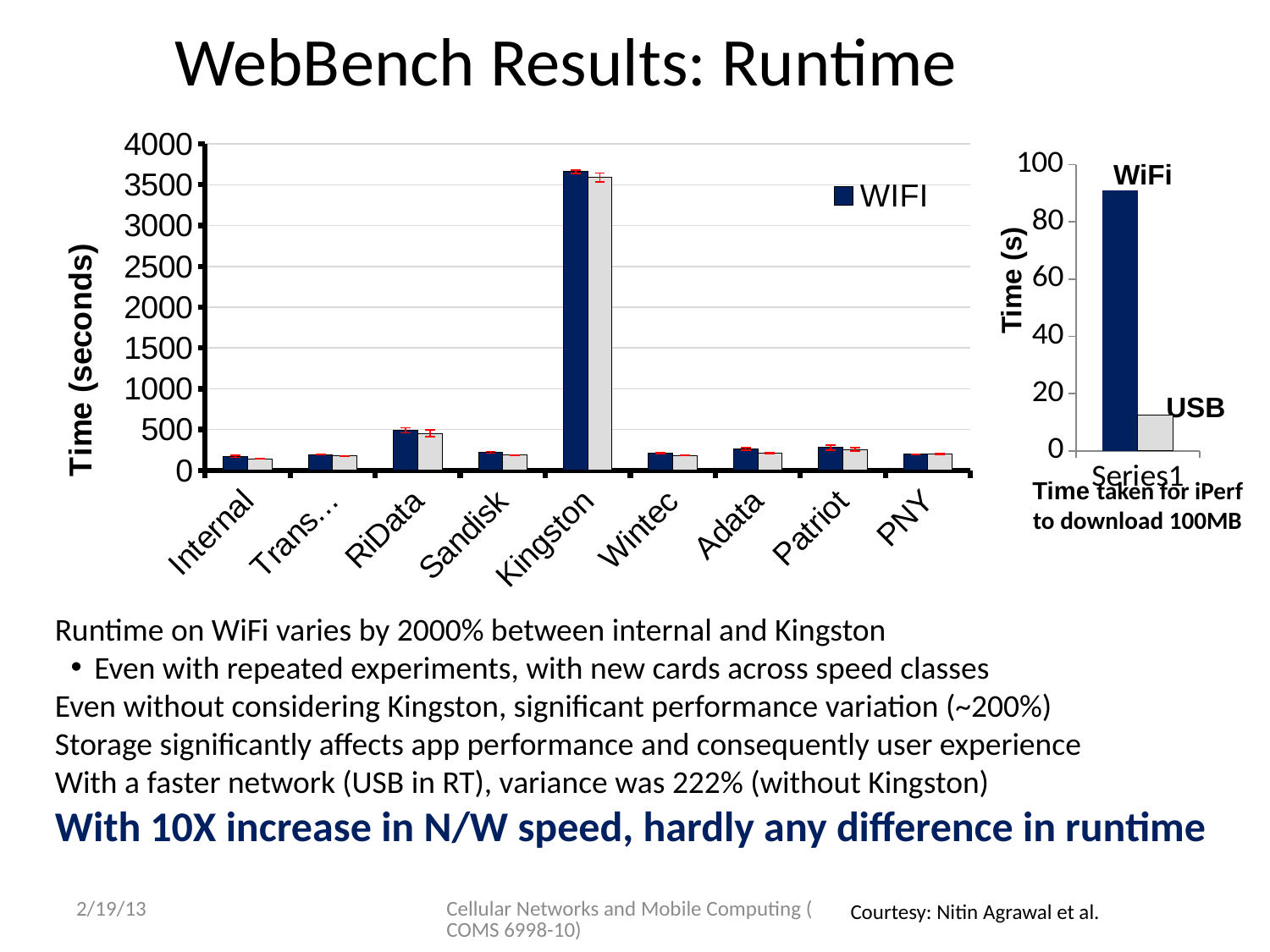
On the large chart on the left, which series name is shown in the legend? WIFI On the small chart on the right (time taken for iPerf to download 100MB), is the value for USB greater or less than 20? less On the small chart on the right (time taken for iPerf to download 100MB), which is larger, WiFi or USB? WiFi What kind of chart is the large chart on the left? bar chart On the large chart on the left, which has the larger WIFI runtime, Kingston or Sandisk? Kingston On the large chart on the left, is the WIFI runtime for Patriot greater or less than 1000 seconds? less On the small chart on the right (time taken for iPerf to download 100MB), is the value for WiFi greater or less than 80? greater On the large chart on the left, what is the label of the y axis? Time (seconds) On the large chart on the left, how many storage card categories are shown on the x axis? 9 On the large chart on the left, which storage card has the highest runtime? Kingston